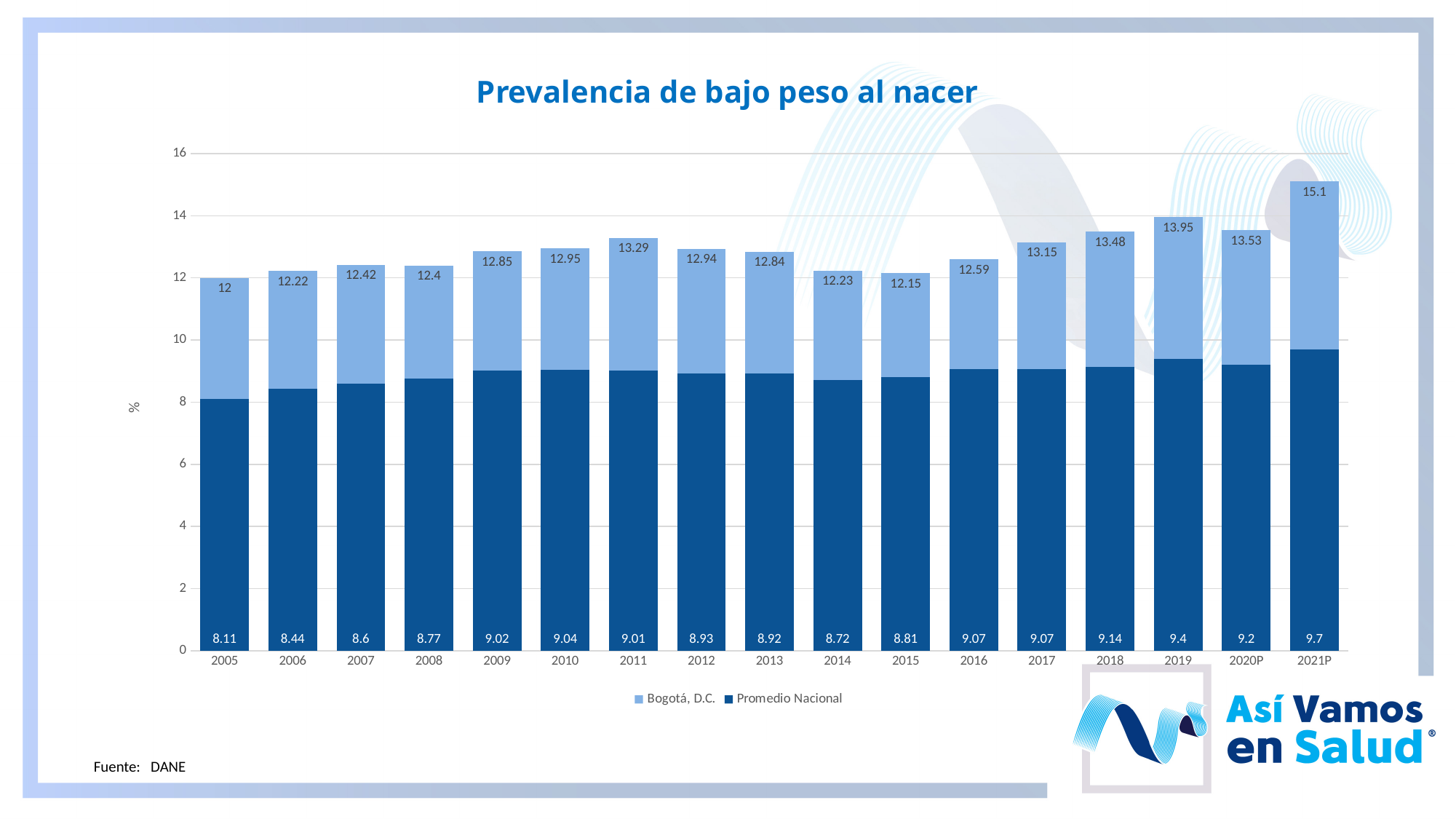
What is the value for Bogotá, D.C. in 2014? 12.23 Which is larger, the Promedio Nacional value in 2019 or in 2020P? 2019 What is the value for Bogotá, D.C. in 2021P? 15.1 What kind of chart is this? bar chart What is the Promedio Nacional value in 2005? 8.11 Is the Bogotá, D.C. value for 2018 greater or less than 14? less What is the difference between the Bogotá, D.C. value and the Promedio Nacional value in 2021P? 5.4 How many series does the legend list? 2 How many years are shown on the x axis? 17 Which year has the lowest Promedio Nacional value? 2005 Which year has the highest Bogotá, D.C. value? 2021P What is the difference between the Bogotá, D.C. values in 2019 and 2020P? 0.42